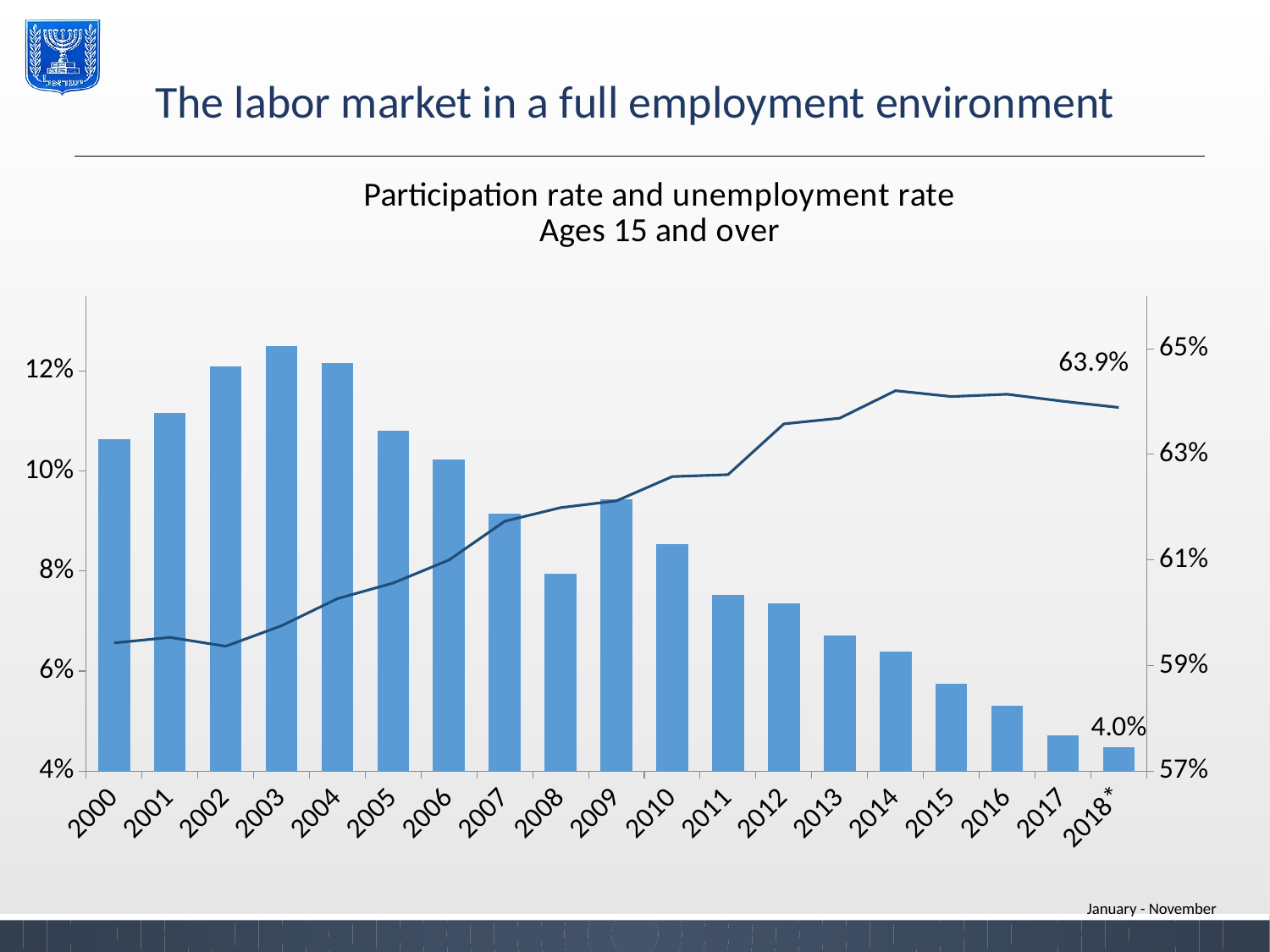
Is the bar value for 2017 greater or less than 6%? less Do the bars rise or fall from 2009 to 2018*? Fall What value is labelled on the bar for 2018*? 4.0% How many years are shown on the x axis? 19 What kind of chart is shown on the slide? A bar chart combined with a line Which year has the larger bar, 2002 or 2010? 2002 What is the title of the chart? Participation rate and unemployment rate Ages 15 and over Does the line generally rise or fall from 2000 to 2014? Rise What value is labelled on the line at 2018*? 63.9% Which year has the shortest bar? 2018* Which year has the tallest bar? 2003